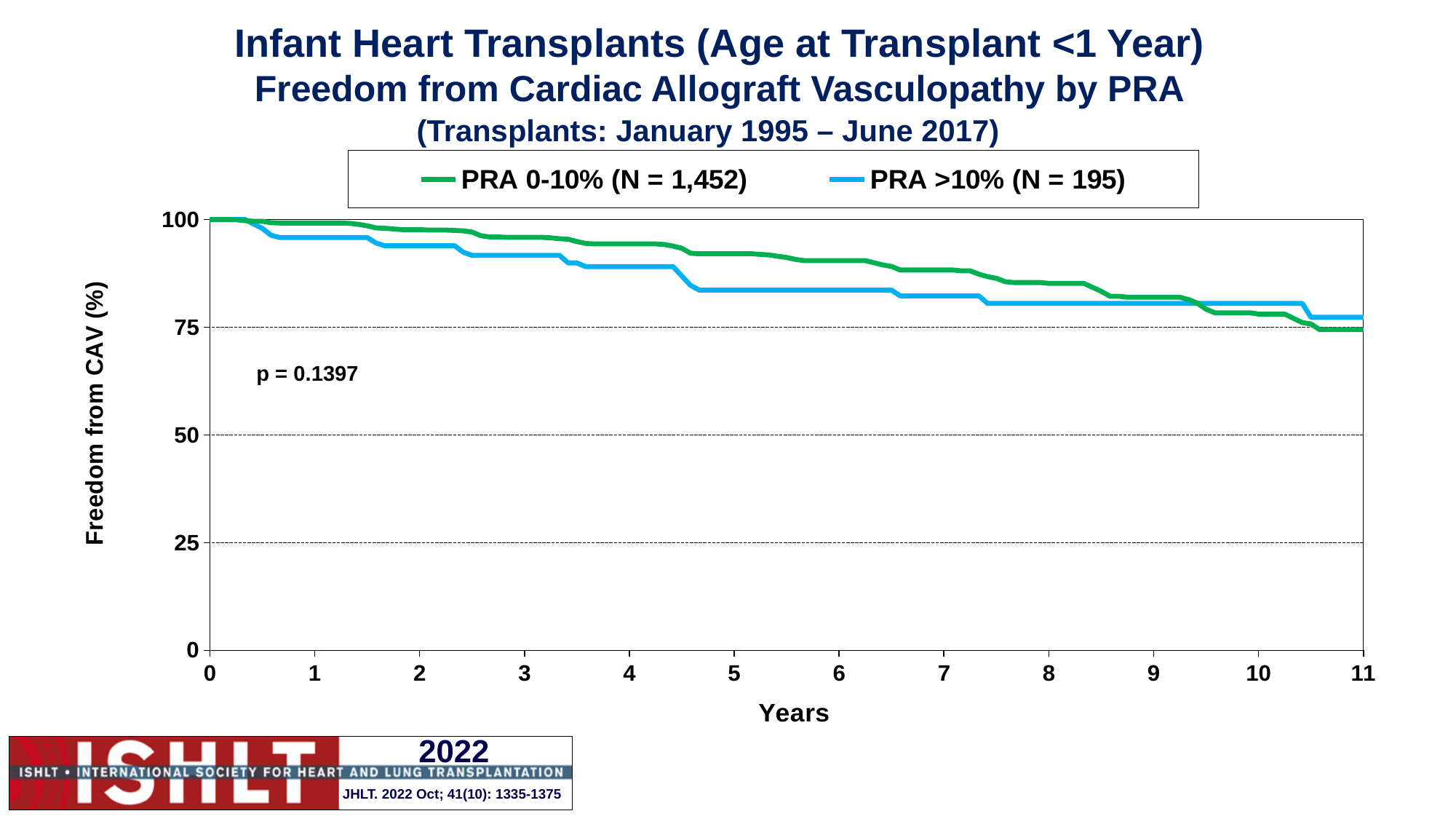
What is the freedom from CAV (%) for PRA >10% at year 0? 100 At year 5, which series has the higher freedom from CAV, PRA 0-10% or PRA >10%? PRA 0-10% What is the freedom from CAV (%) for PRA 0-10% at year 0? 100 What kind of chart is shown on the slide? line chart How many series does the legend list? 2 What p-value is printed on the chart? p = 0.1397 At year 8, which series has the higher freedom from CAV, PRA 0-10% or PRA >10%? PRA 0-10% Is the freedom from CAV for PRA >10% at year 2 greater or less than 75? greater What is the N for the PRA 0-10% group shown in the legend? 1,452 Do the freedom from CAV values rise or fall as years increase? fall Is the freedom from CAV for PRA >10% at year 5 greater or less than 75? greater Is the freedom from CAV for PRA 0-10% at year 5 greater or less than 75? greater